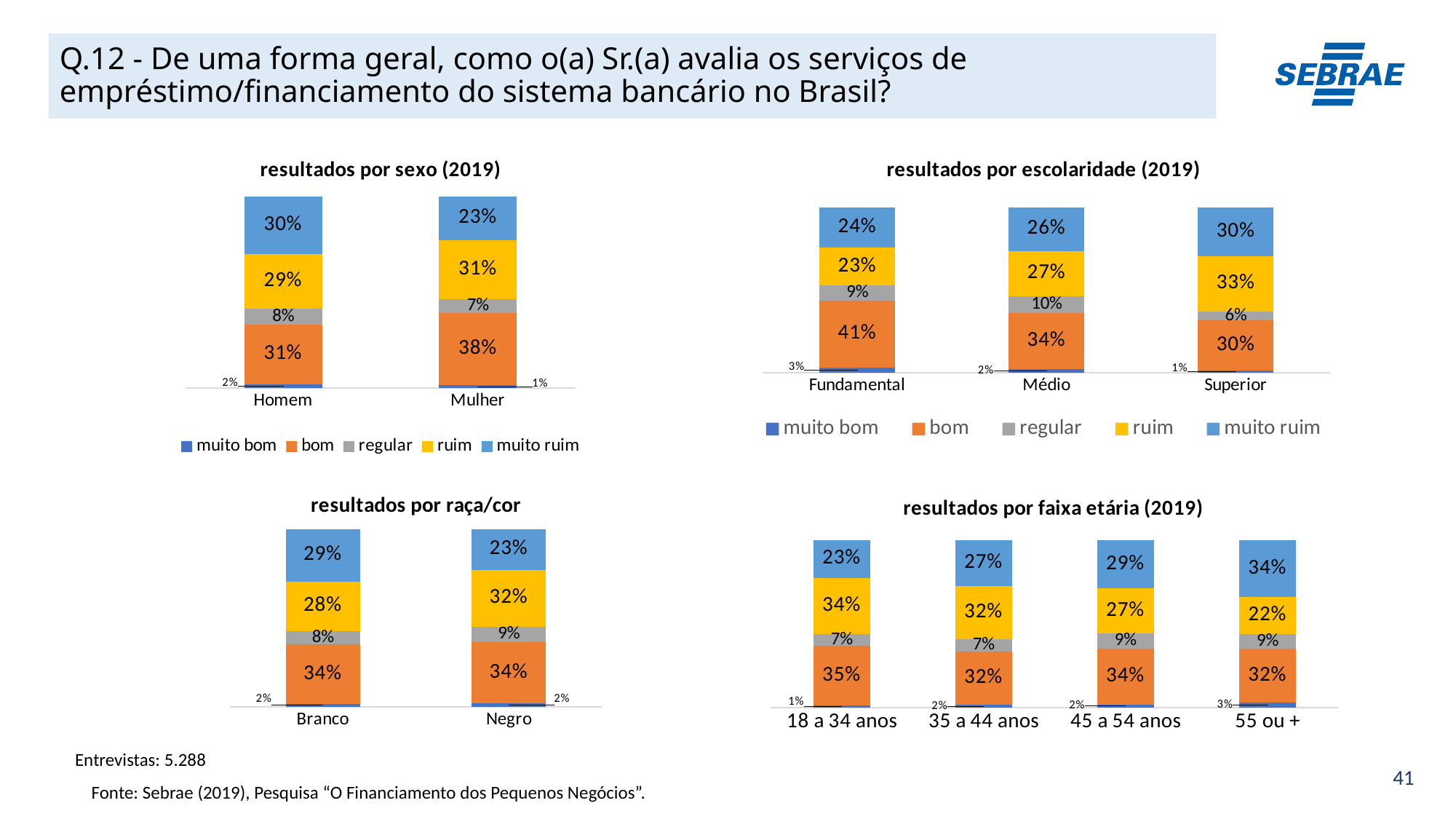
In the chart 'resultados por escolaridade (2019)', what is the 'ruim' value for Superior? 33% In the chart 'resultados por faixa etária (2019)', what is the total of the stacked bar for 18 a 34 anos? 100% In the chart 'resultados por raça/cor', what is the 'regular' value for Negro? 9% In the chart 'resultados por sexo (2019)', what is the value of 'bom' for Mulher? 38% In the chart 'resultados por escolaridade (2019)', how many categories are shown on the x axis? 3 In the chart 'resultados por faixa etária (2019)', which age group has the highest 'muito ruim' value? 55 ou + What kind of chart is 'resultados por faixa etária (2019)'? Stacked bar chart In the chart 'resultados por faixa etária (2019)', which age group has the lowest 'ruim' value? 55 ou + How many series does the legend of the chart 'resultados por sexo (2019)' list? 5 In the chart 'resultados por escolaridade (2019)', which category has the highest 'bom' value? Fundamental In the chart 'resultados por raça/cor', which is larger, the 'ruim' value for Branco or for Negro? Negro In the chart 'resultados por sexo (2019)', what is the difference between the 'muito ruim' values for Homem and Mulher? 7%